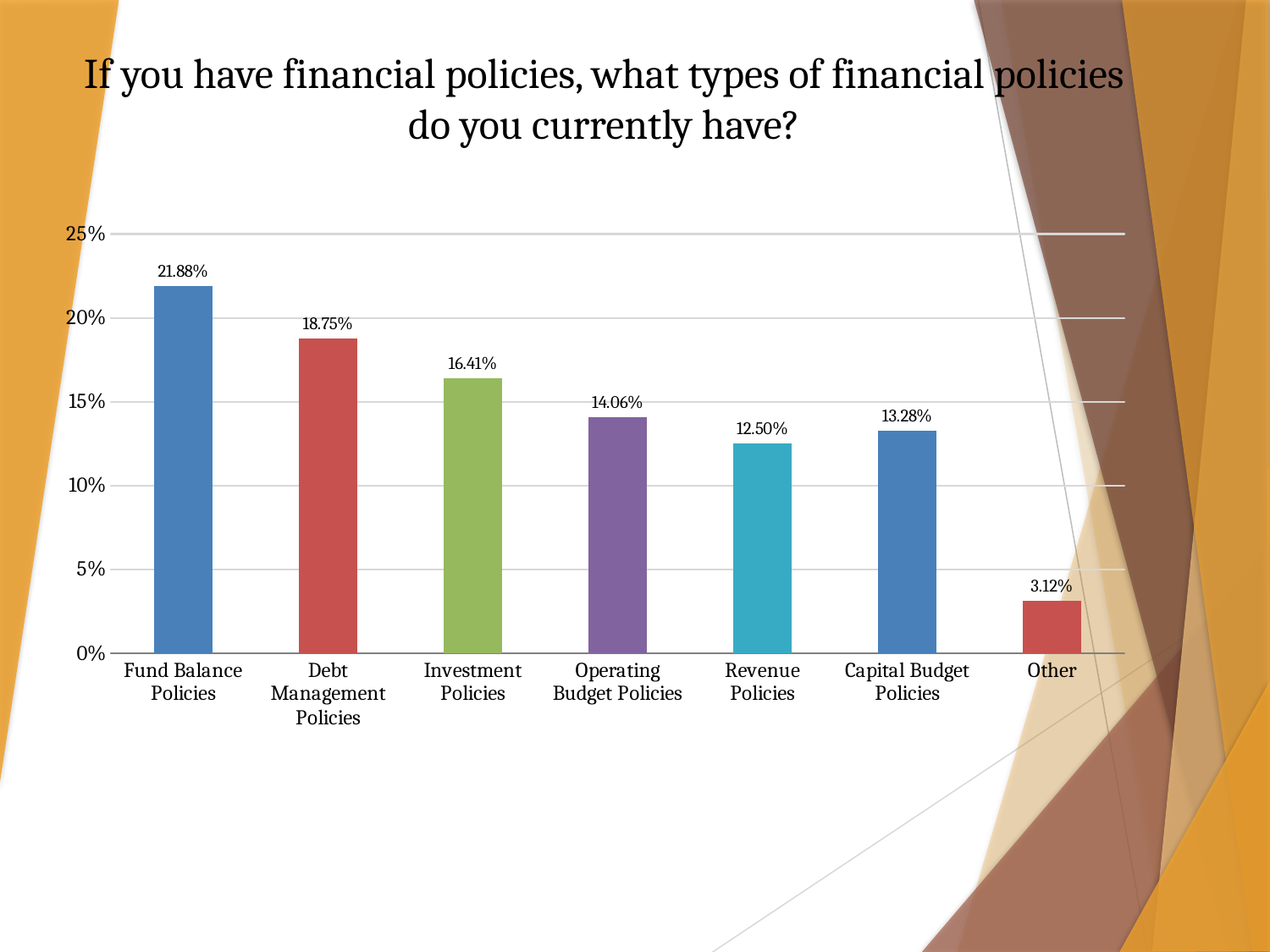
What is the difference between Fund Balance Policies and Debt Management Policies? 3.13% What is the value for Revenue Policies? 12.50% Is the value for Capital Budget Policies greater or less than 15%? less What kind of chart is shown on the slide? bar chart How many categories are shown in the chart? 7 What is the value for Fund Balance Policies? 21.88% What is the title of the chart? If you have financial policies, what types of financial policies do you currently have? What is the value for Debt Management Policies? 18.75% What is the value for Other? 3.12% Which category has the lowest value? Other Which category has the highest value? Fund Balance Policies Which is larger, Investment Policies or Operating Budget Policies? Investment Policies